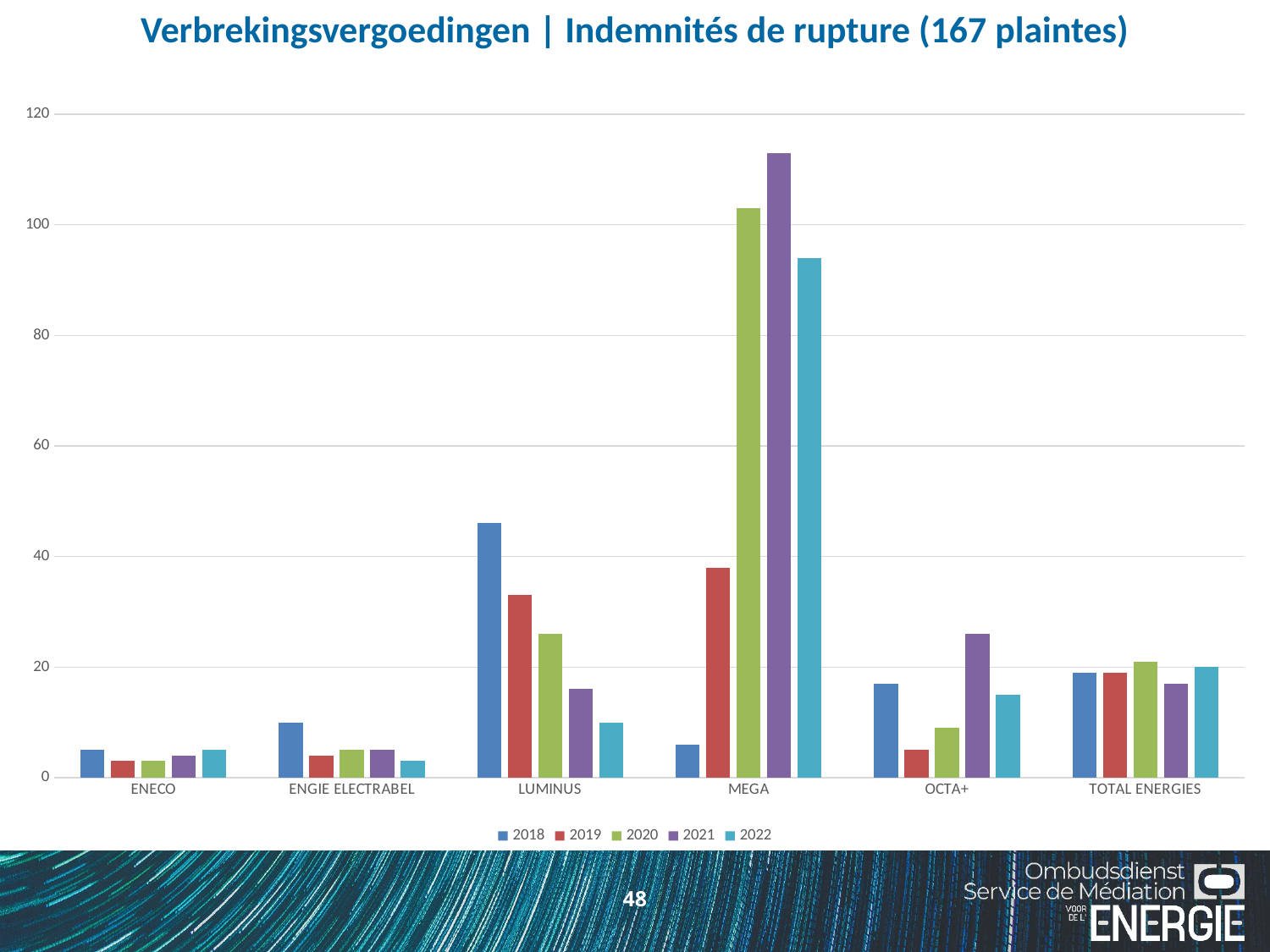
For MEGA, which year has the lowest value? 2018 What kind of chart is shown on the slide? bar chart For MEGA, which is larger: the 2020 value or the 2022 value? 2020 Which supplier has the tallest bar in the chart? MEGA Is the value for MEGA in 2022 greater or less than 80? greater For LUMINUS, do the values rise or fall from 2018 to 2022? fall Is the value for OCTA+ in 2021 greater or less than 20? greater How many series does the legend list? 5 Is the value for LUMINUS in 2018 greater or less than 40? greater How many supplier categories are shown on the x axis? 6 For LUMINUS, which is larger: the 2018 value or the 2019 value? 2018